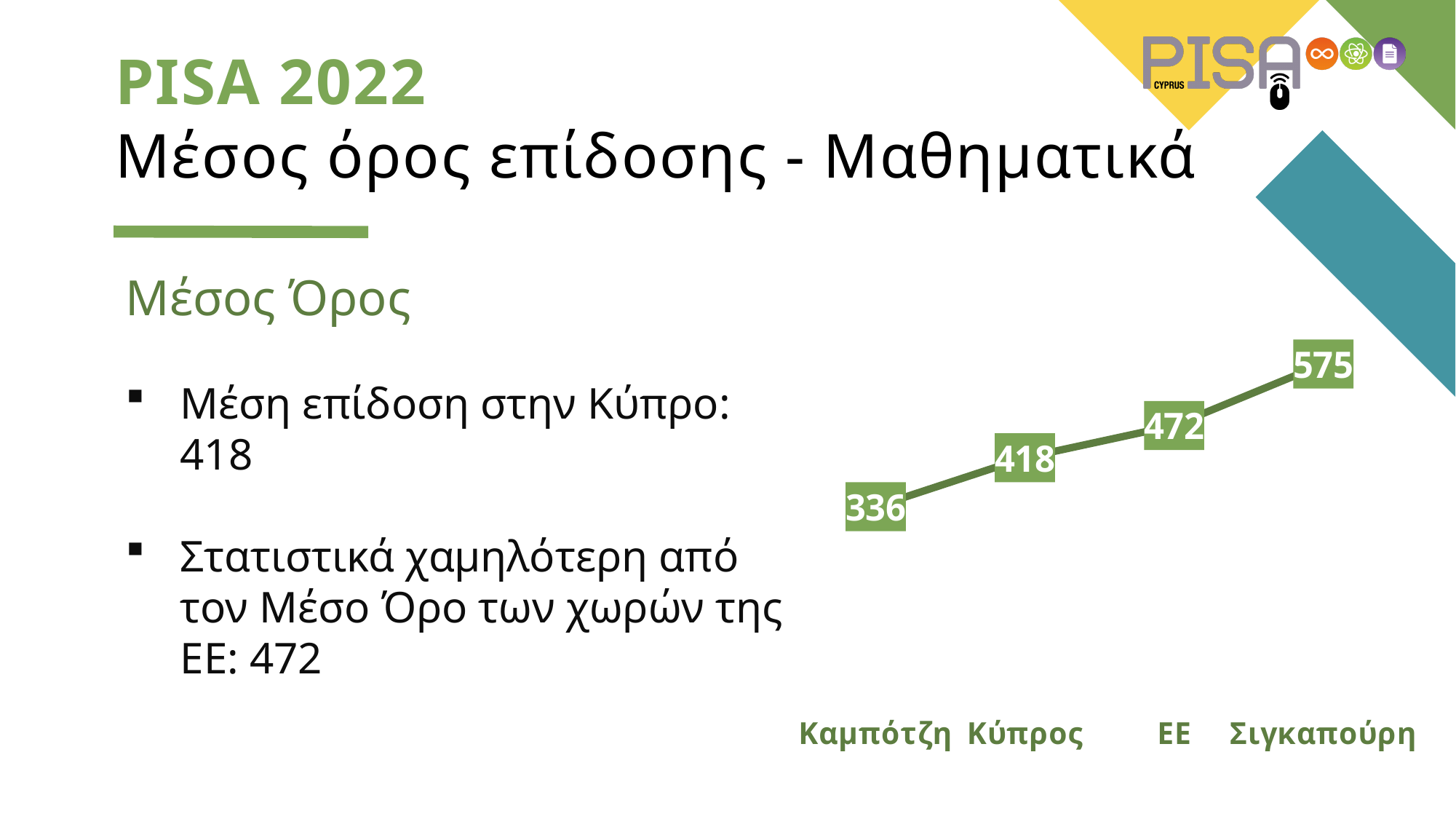
Which category has the highest value in the chart? Σιγκαπούρη What is the value for ΕΕ in the chart? 472 What is the value for Κύπρος in the chart? 418 What kind of chart is shown on the slide? line chart Do the values rise or fall from left to right along the x axis? rise Which category has the lowest value in the chart? Καμπότζη How many categories are plotted in the chart? 4 What is the value for Καμπότζη in the chart? 336 What is the value for Σιγκαπούρη in the chart? 575 What is the difference between the values for ΕΕ and Κύπρος? 54 Which is larger, the value for Κύπρος or the value for ΕΕ? ΕΕ What is the difference between the values for Σιγκαπούρη and Καμπότζη? 239